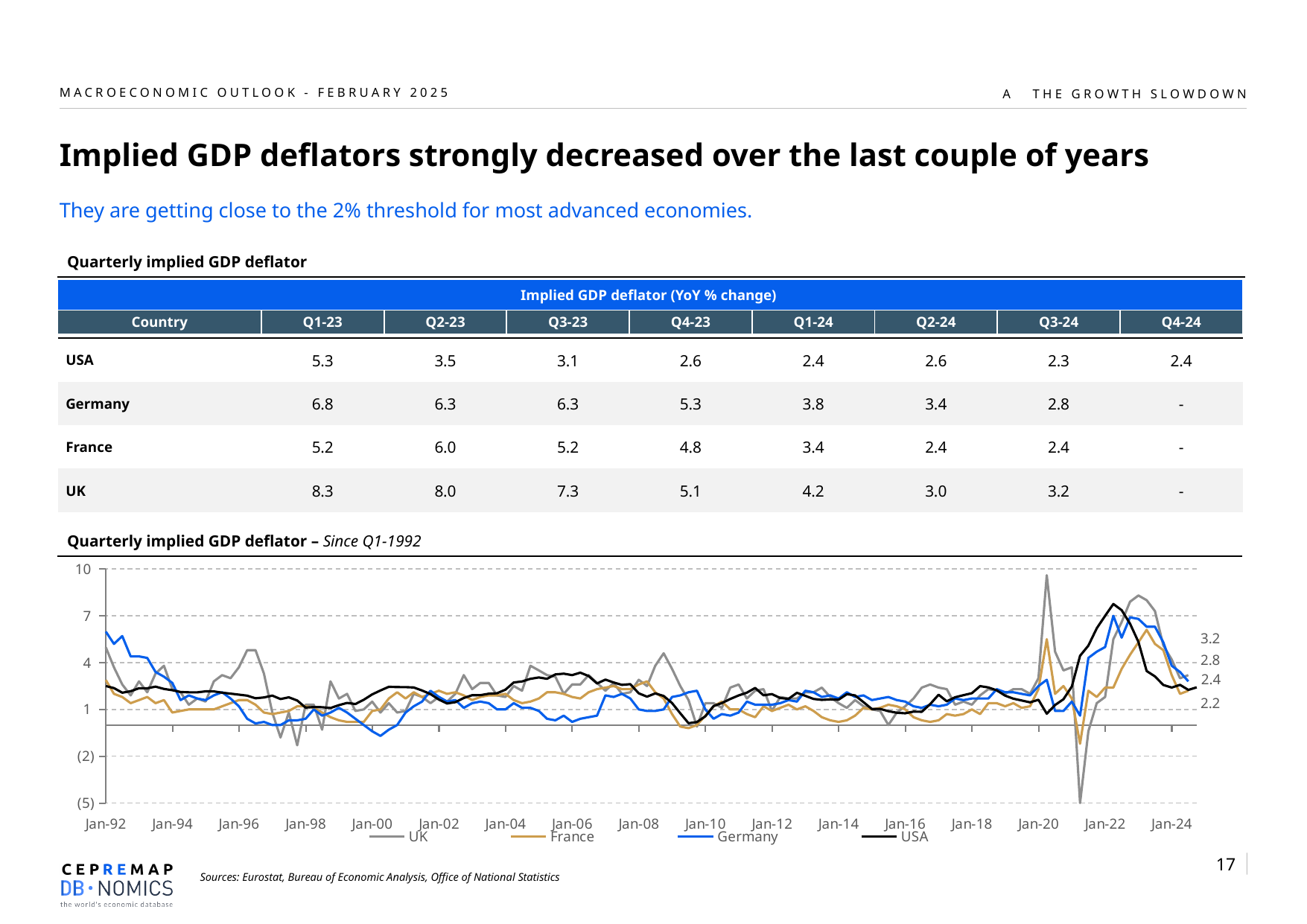
What kind of chart is shown under 'Quarterly implied GDP deflator – Since Q1-1992'? line chart What is the first date label on the x axis of the line chart? Jan-92 In the line chart, is the UK trough shortly after Jan-20 greater or less than (2)? less At the right end of the line chart, which series is higher, UK or France? UK In the line chart, is the UK peak around Jan-20 greater or less than 7? greater Which countries are listed in the legend of the line chart? UK, France, Germany, USA In the line chart, is the value for Germany at Jan-92 greater or less than 4? greater In the line chart, which series is drawn in black? USA How many series does the legend of the line chart list? 4 What is the lowest value printed at the right end of the line chart? 2.2 What is the highest value printed at the right end of the line chart? 3.2